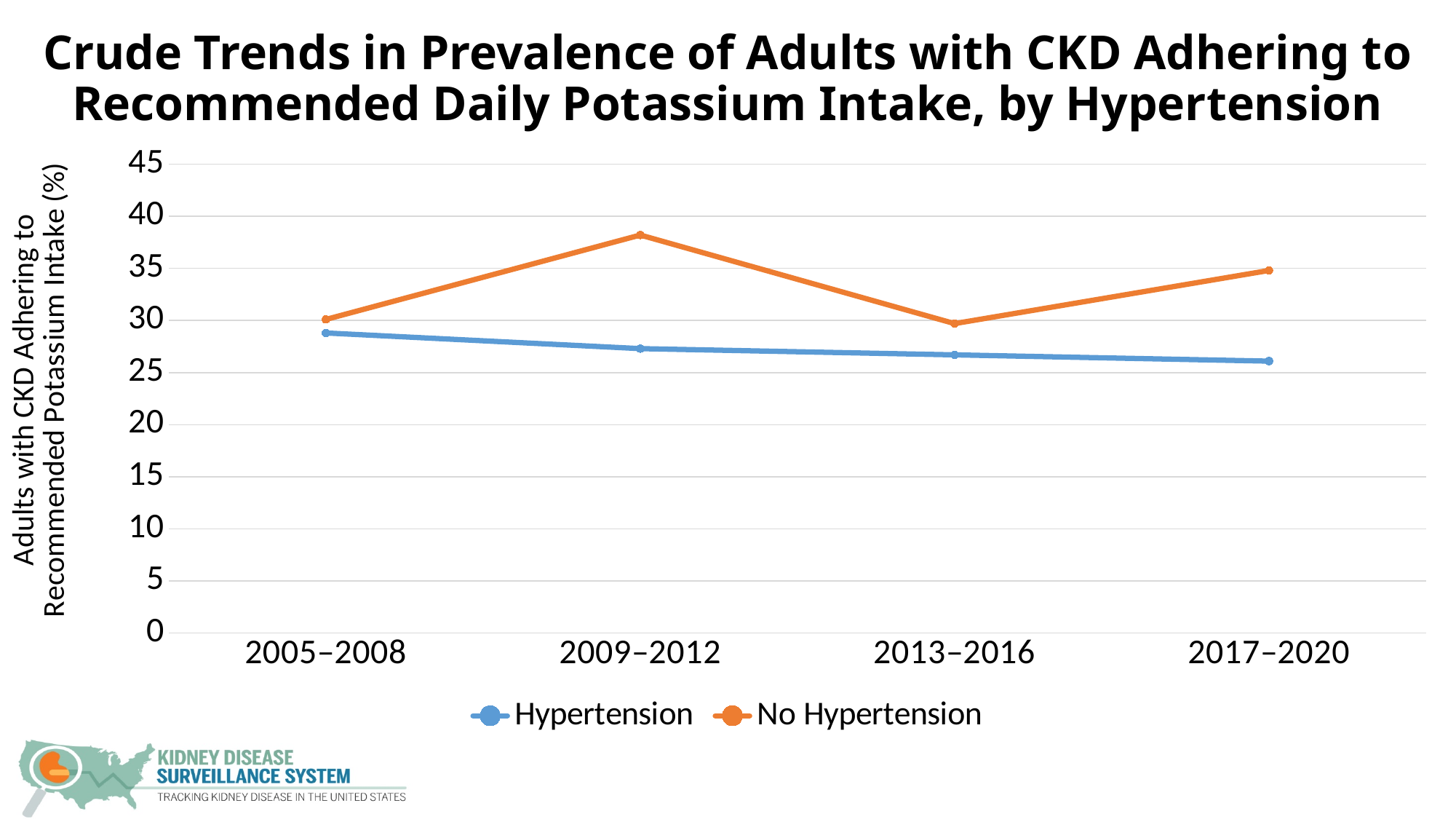
What colour is the line for the No Hypertension series? orange What type of chart is shown on the slide? line chart In which period is the Hypertension series at its lowest? 2017–2020 Is the value for Hypertension in 2009–2012 greater or less than 30? less Does the Hypertension series rise or fall from 2005–2008 to 2017–2020? fall How many series does the legend list? 2 In which period is the Hypertension series at its highest? 2005–2008 Is the value for No Hypertension in 2009–2012 greater or less than 35? greater In which period is the No Hypertension series at its highest? 2009–2012 How many time periods are shown on the x axis? 4 Is the value for No Hypertension in 2017–2020 greater or less than 30? greater Which series has the larger value in 2009–2012, Hypertension or No Hypertension? No Hypertension